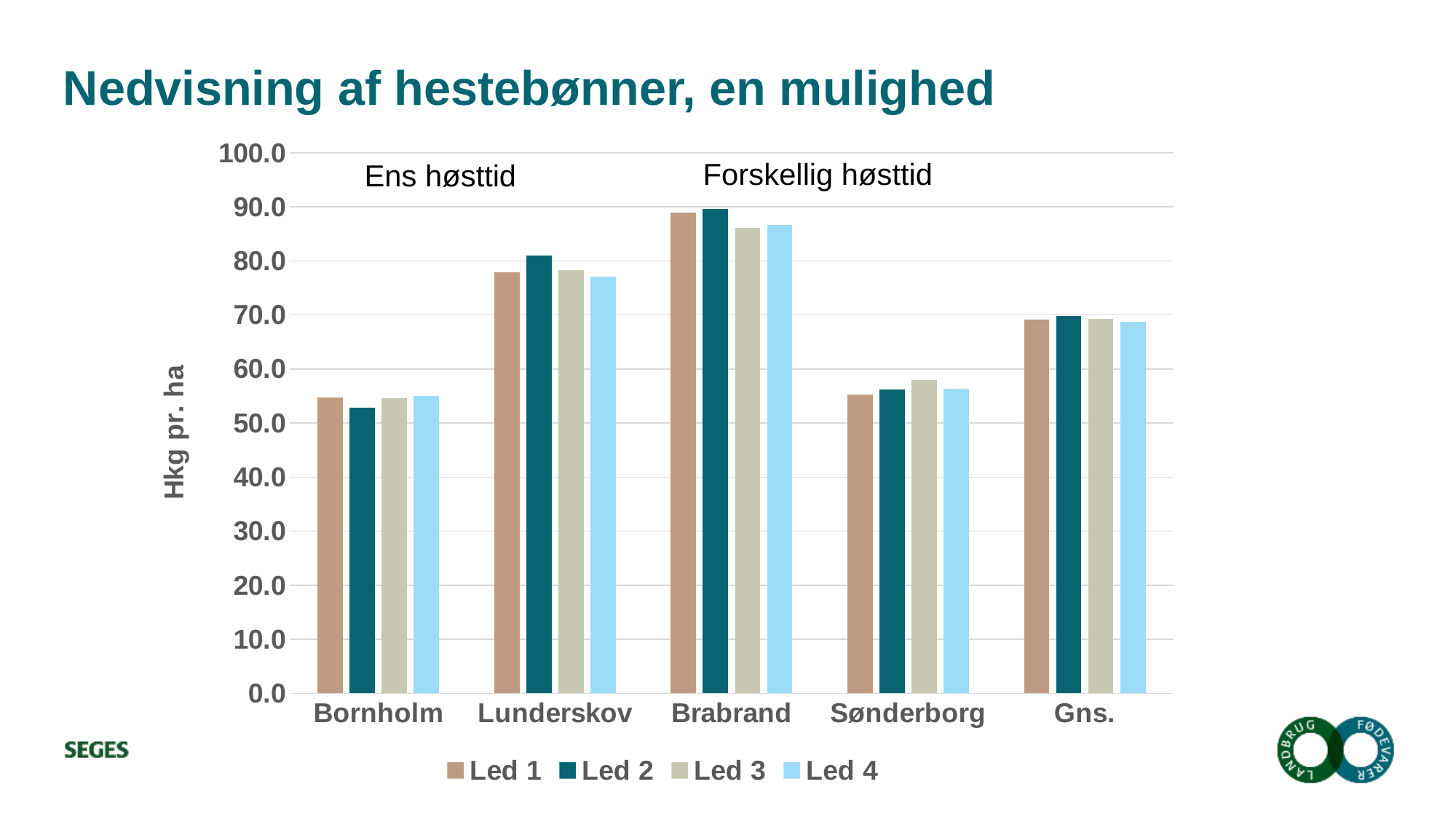
Is the value for Led 1 at Brabrand greater or less than 80.0? greater What kind of chart is shown on the slide? bar chart Which category has the highest values across all series? Brabrand How many categories are shown on the x axis? 5 At Lunderskov, which is larger: Led 2 or Led 4? Led 2 Is the value for Led 4 at Gns. greater or less than 70.0? less Is the value for Led 1 at Lunderskov greater or less than 80.0? less What is the label of the y axis? Hkg pr. ha How many series does the legend list? 4 Which category has the lowest value for Led 2? Bornholm What text annotation appears above the Brabrand and Sønderborg bars? Forskellig høsttid